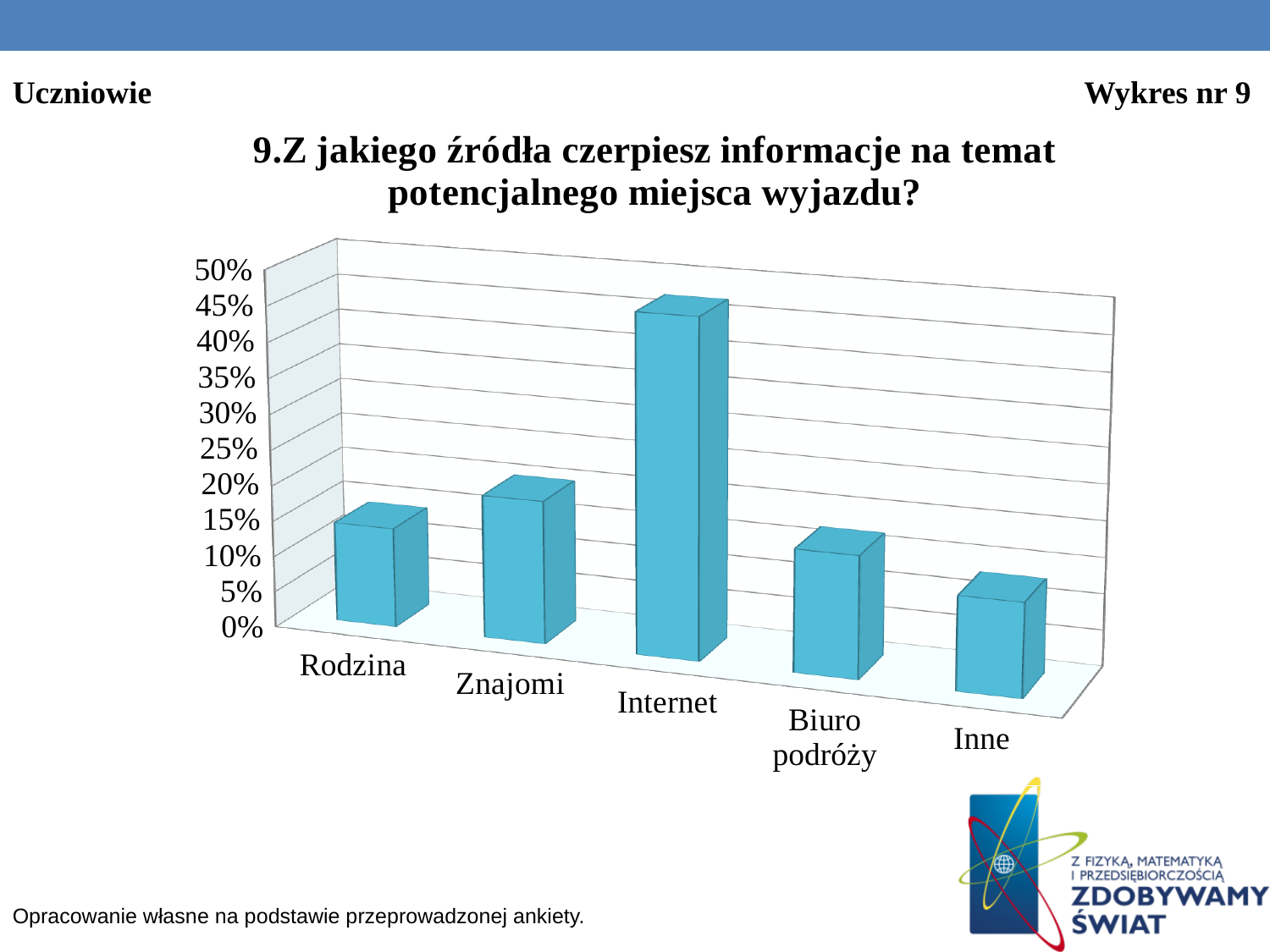
Which is larger, the value for Znajomi or the value for Rodzina? Znajomi What kind of chart is shown on the slide? bar chart Is the value for Inne greater or less than 10%? greater Which category has the highest value in the chart? Internet How many categories are shown on the x axis of the chart? 5 Which is larger, the value for Rodzina or the value for Inne? Rodzina Is the value for Internet greater or less than 50%? less What is the title of the chart? 9.Z jakiego źródła czerpiesz informacje na temat potencjalnego miejsca wyjazdu? Is the value for Internet greater or less than 40%? greater Which category has the lowest value in the chart? Inne